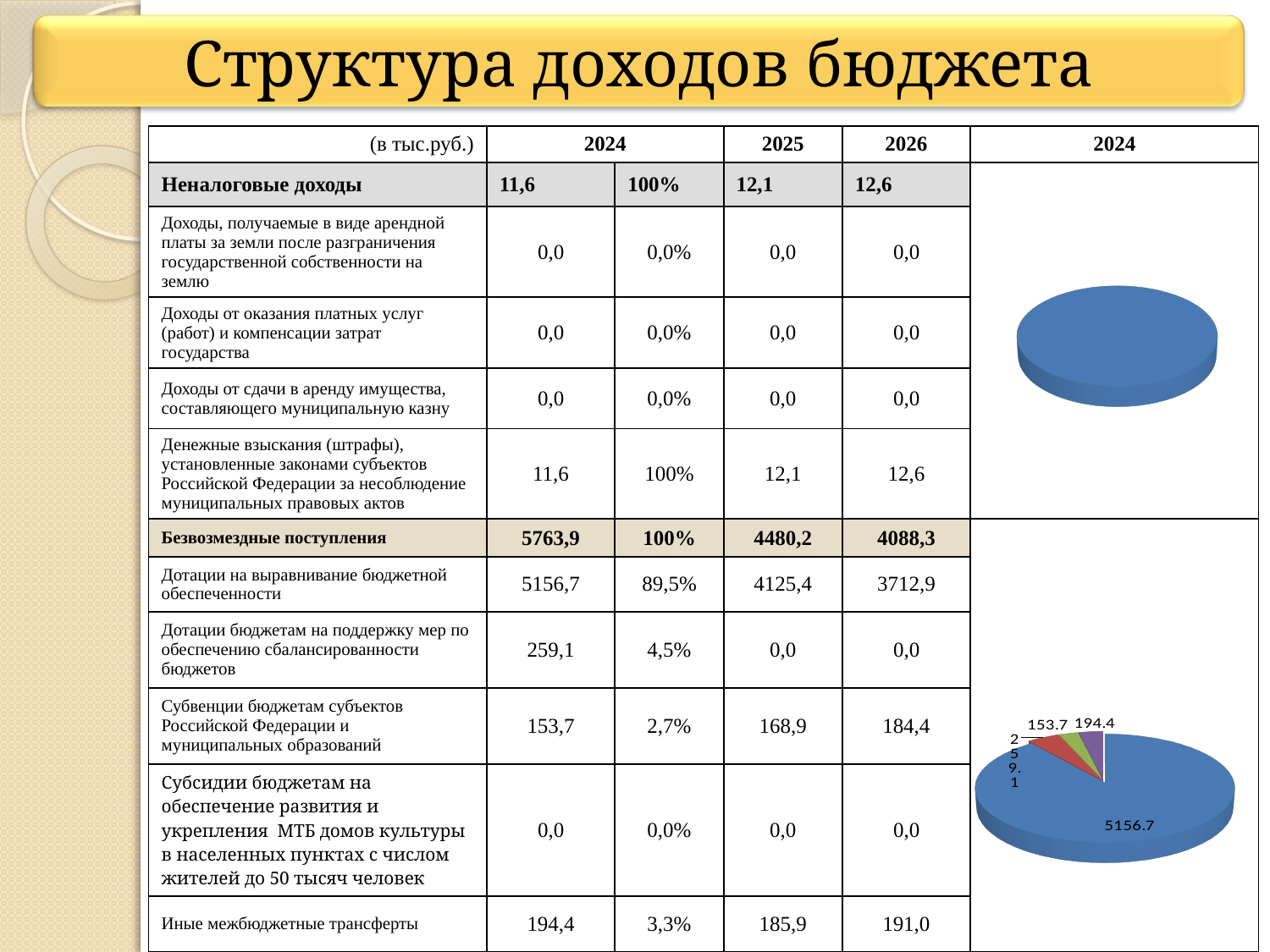
In the lower pie chart, which is larger: the slice labelled 194.4 or the slice labelled 153.7? 194.4 What kind of chart is the lower chart on the right side of the slide? pie chart In the lower pie chart, what is the sum of all four slice values? 5763.9 Which year do the two pie charts on the slide represent, according to the column header above them? 2024 In the lower pie chart, how many slices are there? 4 In the lower pie chart, what share of the total does the slice labelled 5156.7 represent? 89.5% What kind of chart is the upper chart on the right side of the slide? pie chart In the lower pie chart, what value is labelled on the blue slice? 5156.7 In the lower pie chart, what is the value of the largest slice? 5156.7 In the lower pie chart, what is the difference between the slices labelled 194.4 and 153.7? 40.7 In the upper pie chart, how many slices are visible? 1 In the lower pie chart, what is the value of the smallest slice? 153.7